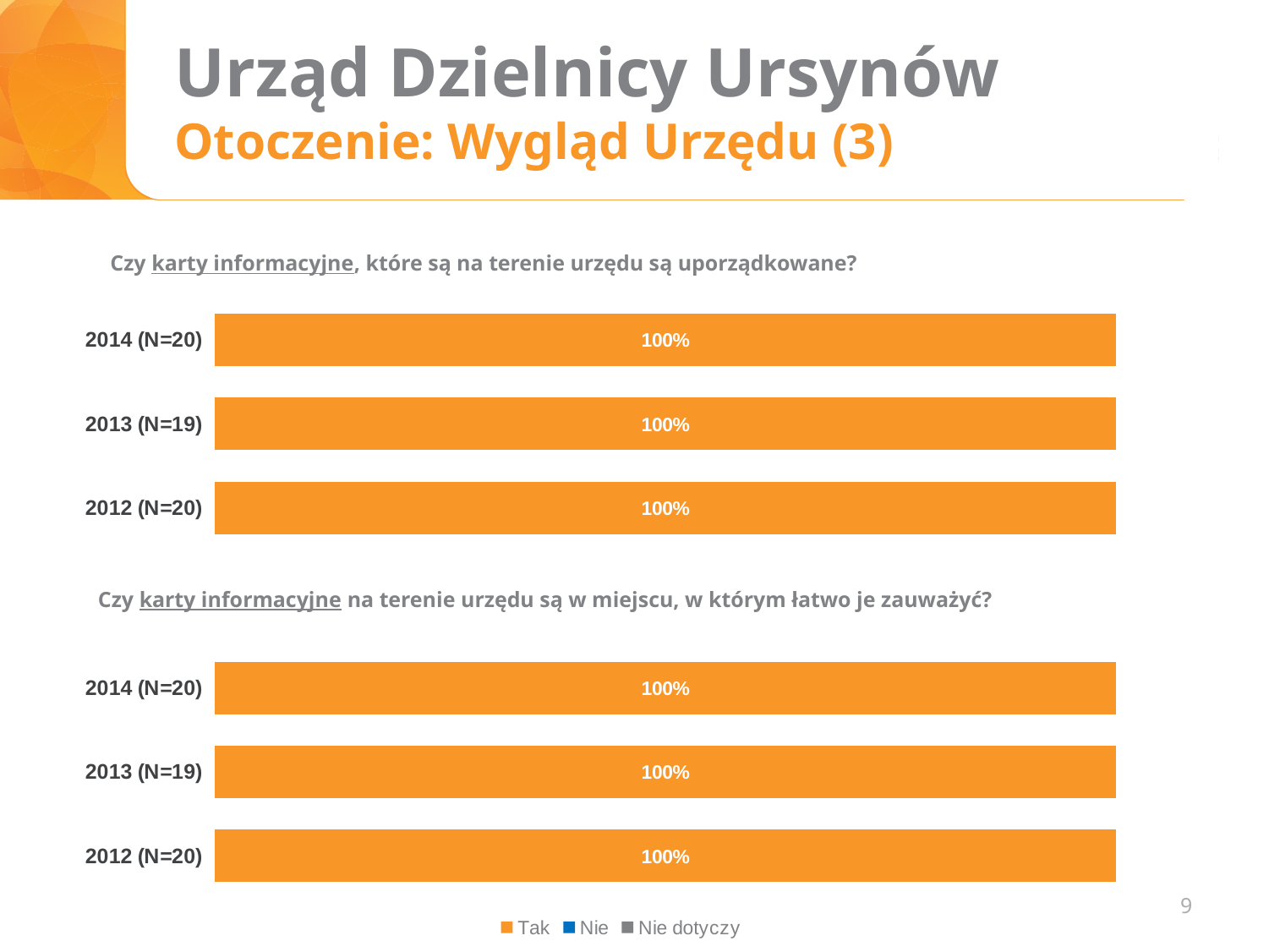
How many series does the legend at the bottom of the slide list? 3 What kind of chart is the top chart? Bar chart In the bottom chart ("Czy karty informacyjne na terenie urzędu są w miejscu, w którym łatwo je zauważyć?"), what is the value for 2013 (N=19)? 100% Which legend entry is shown in orange? Tak How many categories (years) are shown in the bottom chart? 3 In the bottom chart ("Czy karty informacyjne na terenie urzędu są w miejscu, w którym łatwo je zauważyć?"), what is the value for 2014 (N=20)? 100% In the top chart ("Czy karty informacyjne, które są na terenie urzędu są uporządkowane?"), what is the value for 2012 (N=20)? 100% In the top chart, what is the difference between the values for 2014 (N=20) and 2012 (N=20)? 0% How many categories (years) are shown in the top chart? 3 In the bottom chart, do the values change between 2012 (N=20) and 2014 (N=20)? No, they stay at 100% What are the three entries listed in the legend? Tak, Nie, Nie dotyczy In the top chart ("Czy karty informacyjne, które są na terenie urzędu są uporządkowane?"), what is the value for 2014 (N=20)? 100%